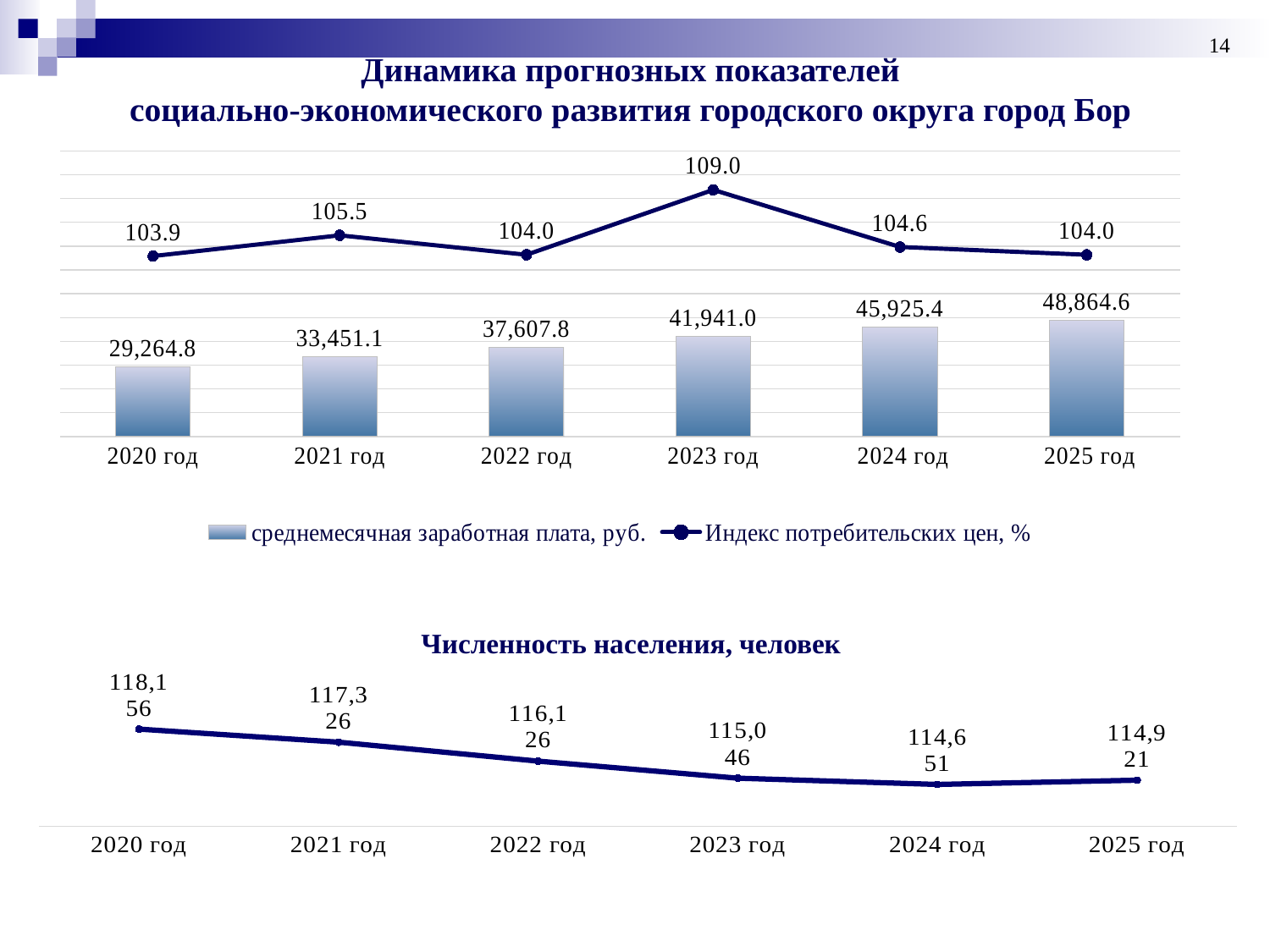
How many series does the legend of the top chart list? 2 In the top chart, is the consumer price index higher in 2021 год or in 2024 год? 2021 год What kind of chart is the bottom chart titled 'Численность населения, человек'? Line chart In the top chart, what is the consumer price index (Индекс потребительских цен) for 2023 год? 109.0 In the top chart, how do the average monthly wage values change from 2020 год to 2025 год? They rise In the bottom chart 'Численность населения, человек', how many years are plotted? 6 In the top chart, which year has the lowest average monthly wage? 2020 год In the top chart, what is the difference between the average monthly wage in 2025 год and 2024 год? 2,939.2 In the top chart, by how much does the consumer price index in 2023 год exceed that in 2022 год? 5.0 In the bottom chart 'Численность населения, человек', which year has the highest population? 2020 год In the top chart, which year has the highest consumer price index? 2023 год In the top chart, what is the average monthly wage (среднемесячная заработная плата) for 2020 год? 29,264.8